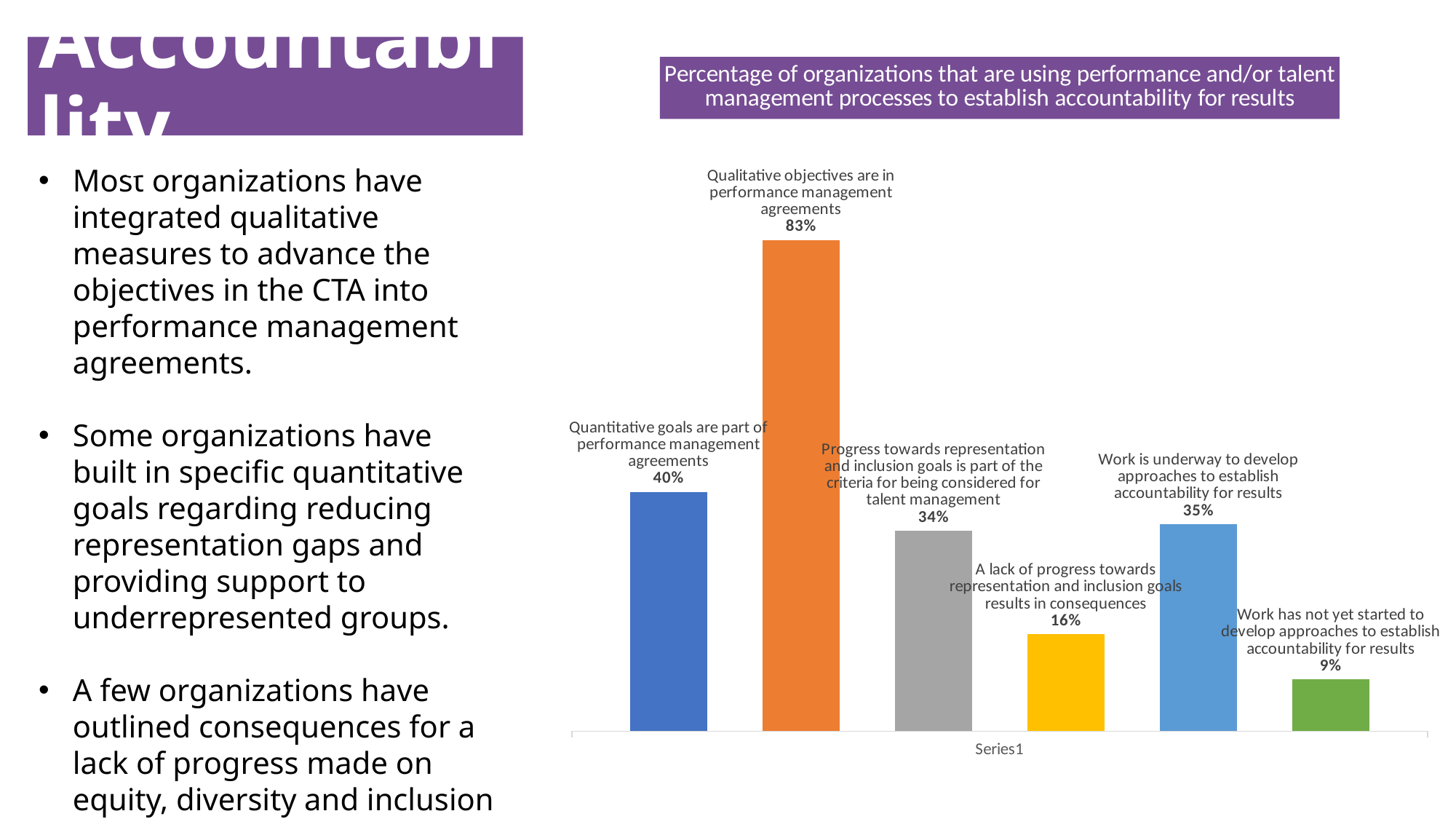
Which category has the lowest percentage? Work has not yet started to develop approaches to establish accountability for results What is the difference between the percentage for qualitative objectives in performance management agreements and the percentage for quantitative goals in performance management agreements? 43% Which category has the highest percentage? Qualitative objectives are in performance management agreements How many bars are shown in the chart? 6 What is the title of the chart? Percentage of organizations that are using performance and/or talent management processes to establish accountability for results What type of chart is shown on the slide? Bar chart What percentage of organizations have quantitative goals as part of performance management agreements? 40% What percentage of organizations have not yet started to develop approaches to establish accountability for results? 9% Which is larger: the percentage for work underway to develop approaches to establish accountability for results, or the percentage for progress towards representation and inclusion goals being part of talent management criteria? Work is underway to develop approaches to establish accountability for results What percentage of organizations report that a lack of progress towards representation and inclusion goals results in consequences? 16% What percentage of organizations have qualitative objectives in performance management agreements? 83% What colour is the bar for qualitative objectives in performance management agreements? Orange